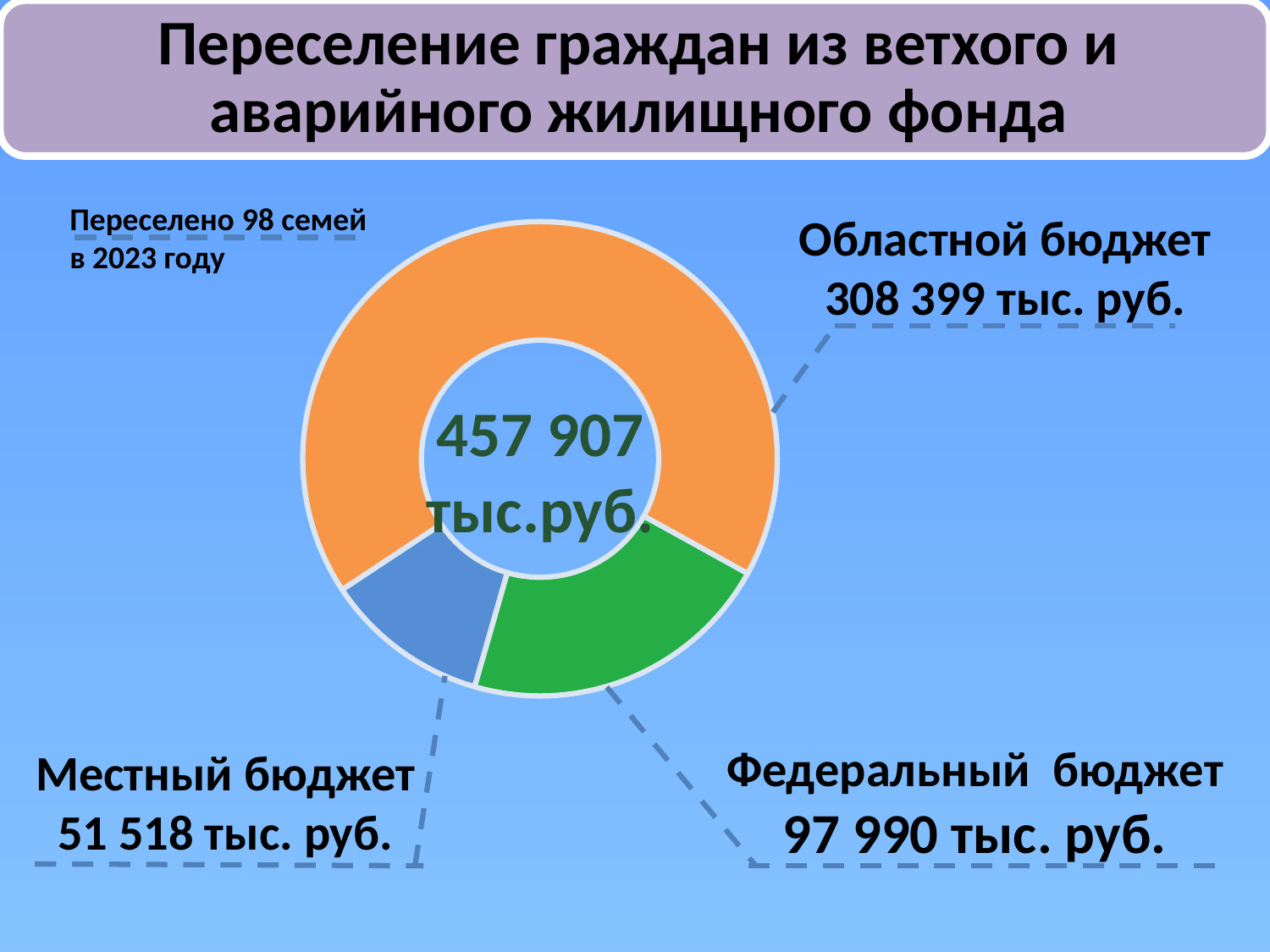
What total value is shown in the centre of the chart? 457 907 тыс.руб. What is the value for Местный бюджет? 51 518 тыс. руб. Which budget source has the smallest value? Местный бюджет What is the value for Федеральный бюджет? 97 990 тыс. руб. What is the difference between Областной бюджет and Федеральный бюджет? 210 409 тыс. руб. How many segments does the chart have? 3 What kind of chart is shown on the slide? Donut (pie) chart What colour is the segment for Федеральный бюджет? Green What is the difference between Федеральный бюджет and Местный бюджет? 46 472 тыс. руб. What is the value for Областной бюджет? 308 399 тыс. руб. Which is larger, Федеральный бюджет or Местный бюджет? Федеральный бюджет Which budget source has the largest value? Областной бюджет